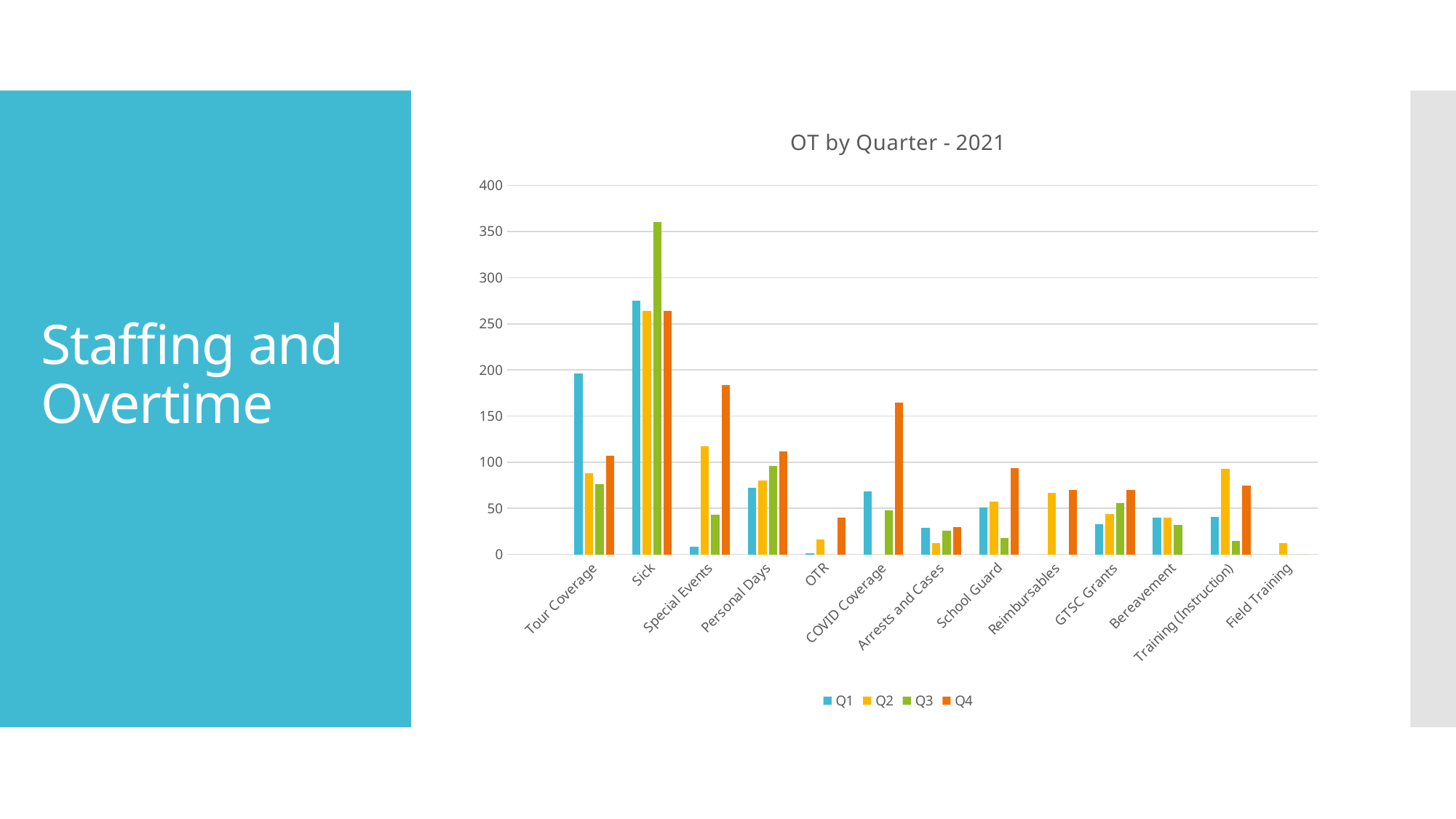
Which category has the tallest bar in the chart? Sick How many series does the legend list? 4 How many categories are shown on the x axis? 13 For the Sick category, which quarter has the highest value? Q3 For the Special Events category, which quarter has the highest value? Q4 Is the Q3 value for Sick greater or less than 350? greater Is the Q2 value for Field Training greater or less than 50? less For Tour Coverage, which is larger, the Q1 value or the Q4 value? Q1 What is the title of the chart? OT by Quarter - 2021 Is the Q4 value for COVID Coverage greater or less than 150? greater What type of chart is shown on the slide? bar chart